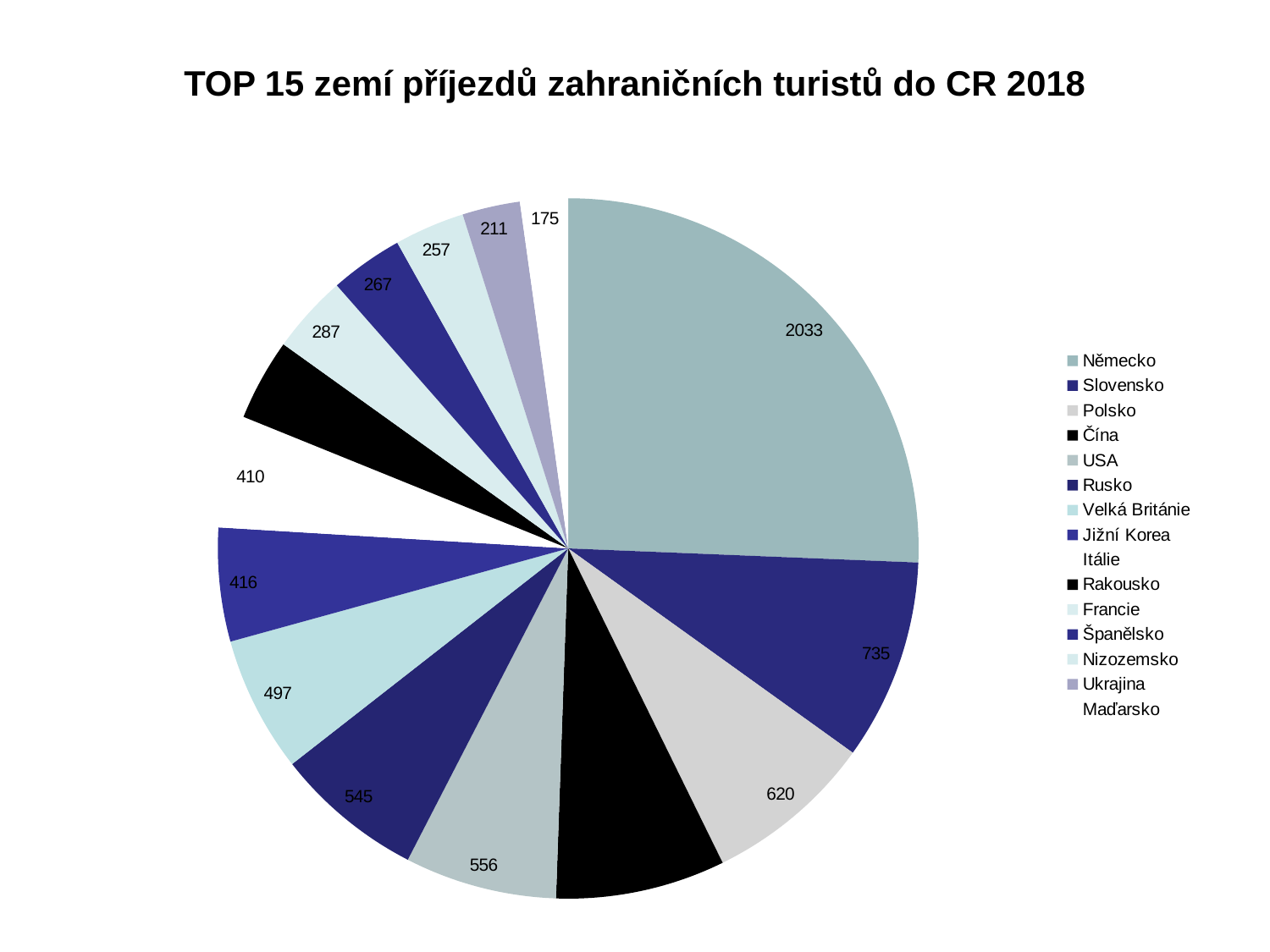
What value is shown for Německo? 2033 What kind of chart is shown on the slide? Pie chart What value is shown for Maďarsko? 175 What is the title of the chart? TOP 15 zemí příjezdů zahraničních turistů do CR 2018 Which country has the largest slice of the pie? Německo What value is shown for USA? 556 Which country has the smallest slice of the pie? Maďarsko How many countries are shown in the pie chart? 15 Which is larger, the value for Rusko or the value for Velká Británie? Rusko What is the difference between the values for Německo and Slovensko? 1298 What value is shown for Polsko? 620 What value is shown for Slovensko? 735